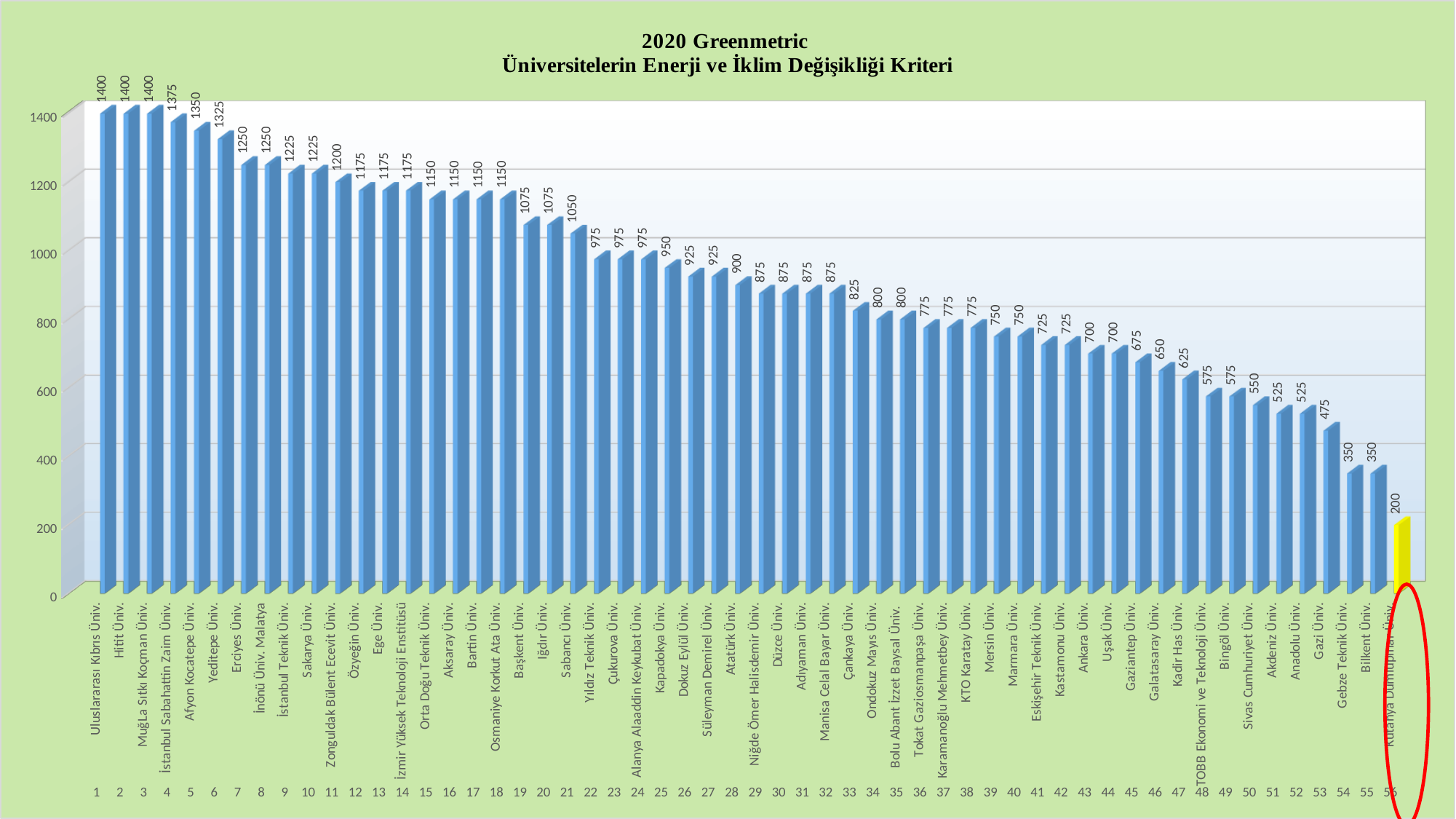
How many universities are shown in the chart? 56 What is the value for Gazi Üniv.? 475 What is the value for Kütahya Dumlupınar Üniv.? 200 Which university has the lowest value? Kütahya Dumlupınar Üniv. What is the value for Atatürk Üniv.? 900 What kind of chart is shown on the slide? bar chart What is the difference between the values for Bilkent Üniv. and Kütahya Dumlupınar Üniv.? 150 Which is larger, the value for Kapadokya Üniv. or the value for Çankaya Üniv.? Kapadokya Üniv. What is the difference between the values for Yeditepe Üniv. and Erciyes Üniv.? 75 What is the value for Sabancı Üniv.? 1050 Do the values rise or fall from left to right along the x axis? fall Is the value for Galatasaray Üniv. greater or less than 600? greater